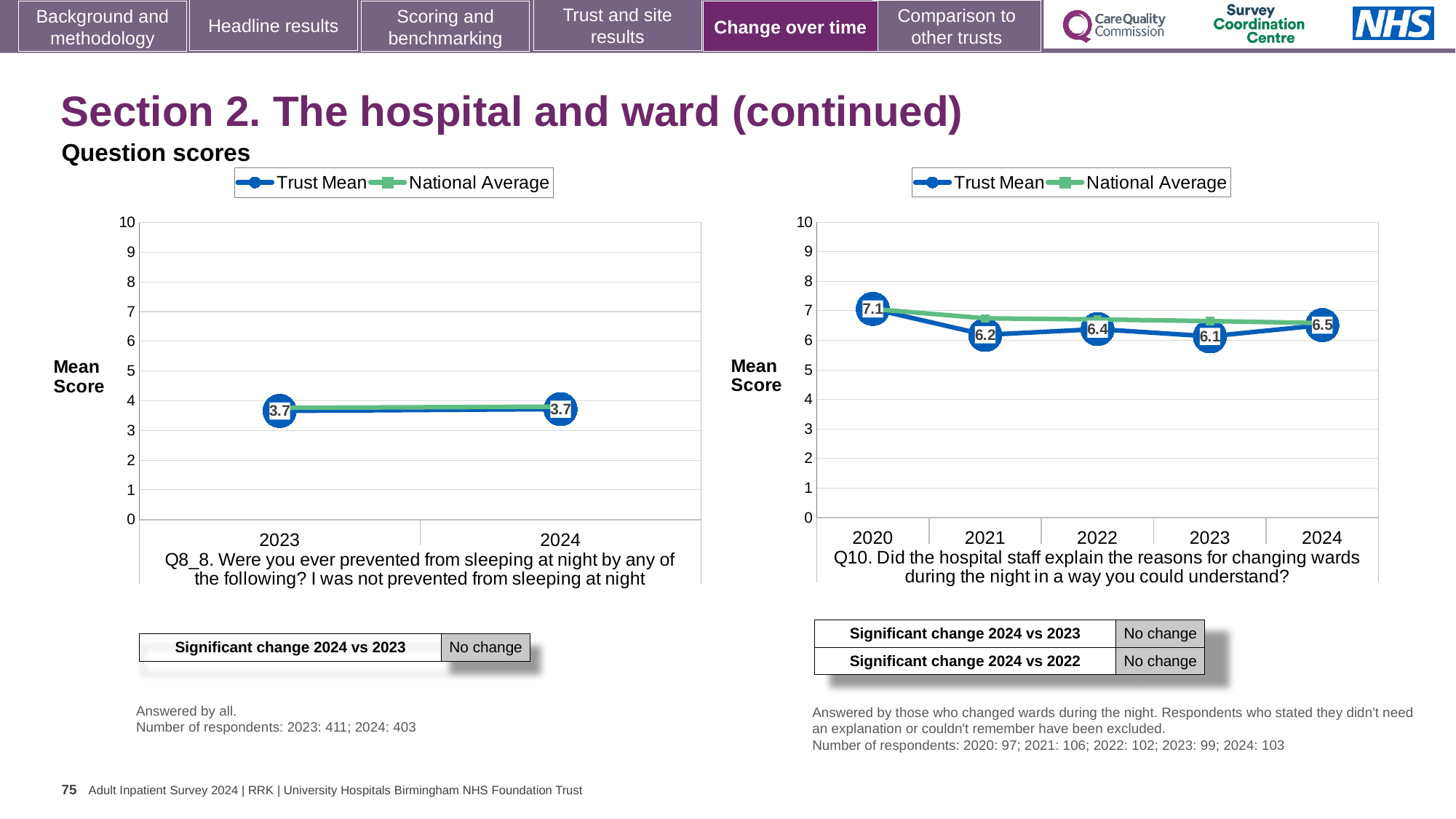
On the right chart (Q10), which year has the highest Trust Mean? 2020 On the right chart (Q10), is the Trust Mean higher in 2022 or in 2021? 2022 On the left chart (Q8_8), what is the Trust Mean for 2023? 3.7 On the right chart (Q10), what is the difference between the Trust Mean in 2020 and in 2024? 0.6 On the right chart (Q10), what is the Trust Mean for 2023? 6.1 How many series does the legend of the left chart (Q8_8) list? 2 On the left chart (Q8_8), what is the Trust Mean for 2024? 3.7 How many years are shown on the x axis of the right chart (Q10)? 5 On the right chart (Q10), what is the Trust Mean for 2020? 7.1 What type of chart is the right chart (Q10)? Line chart On the right chart (Q10), is the Trust Mean for 2020 greater or less than 7? greater On the right chart (Q10), which year has the lowest Trust Mean? 2023